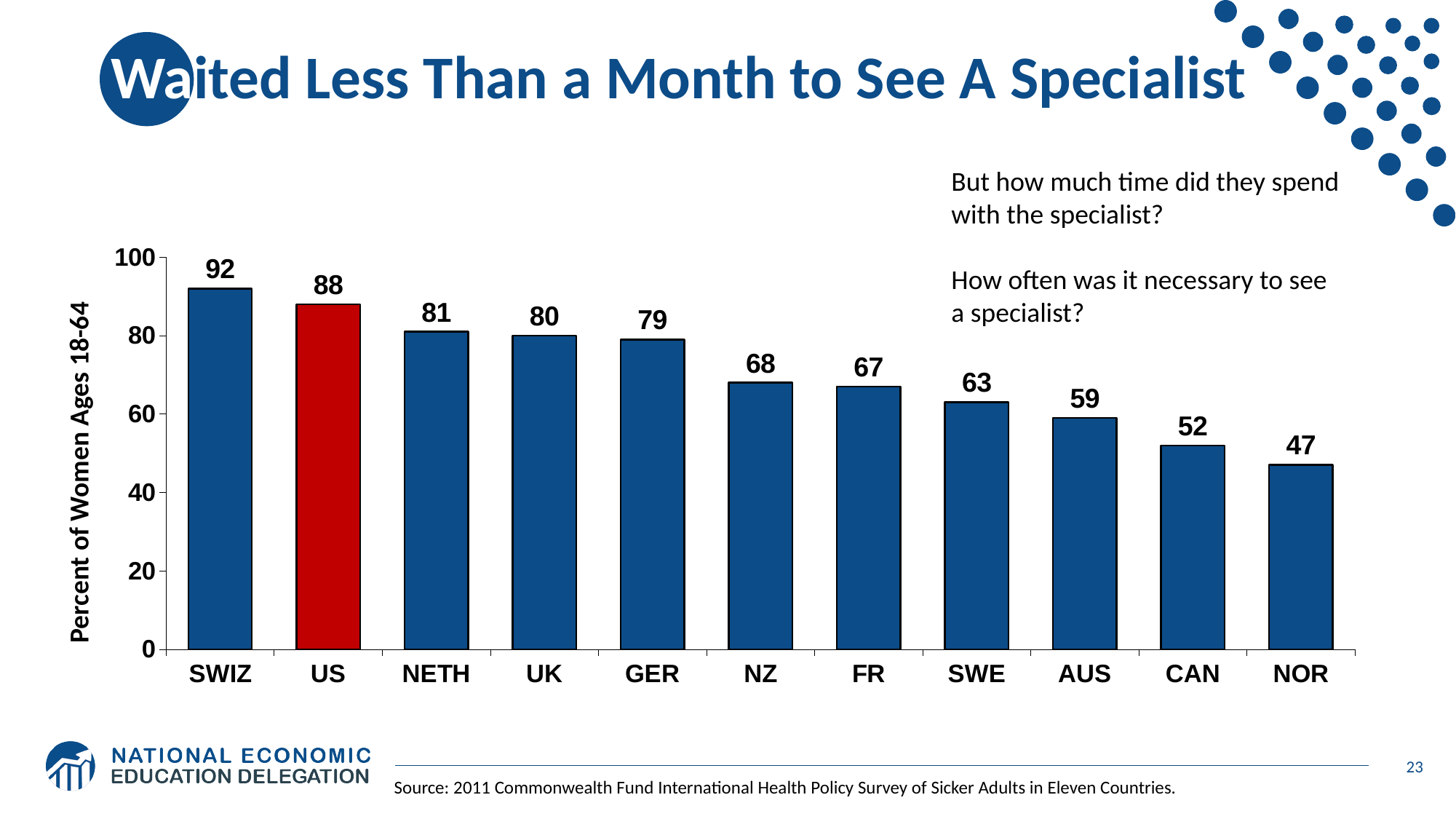
What kind of chart is shown on the slide? bar chart Which country's bar is coloured red? US Is the value for AUS greater or less than 60? less Which is larger, the value for NZ or the value for SWE? NZ What is the value for the US? 88 What is the difference between the values for CAN and NOR? 5 What is the difference between the values for SWIZ and the US? 4 What is the value for NOR? 47 Which country has the lowest value? NOR Which country has the highest value? SWIZ How many countries are shown on the chart? 11 What is the value for GER? 79